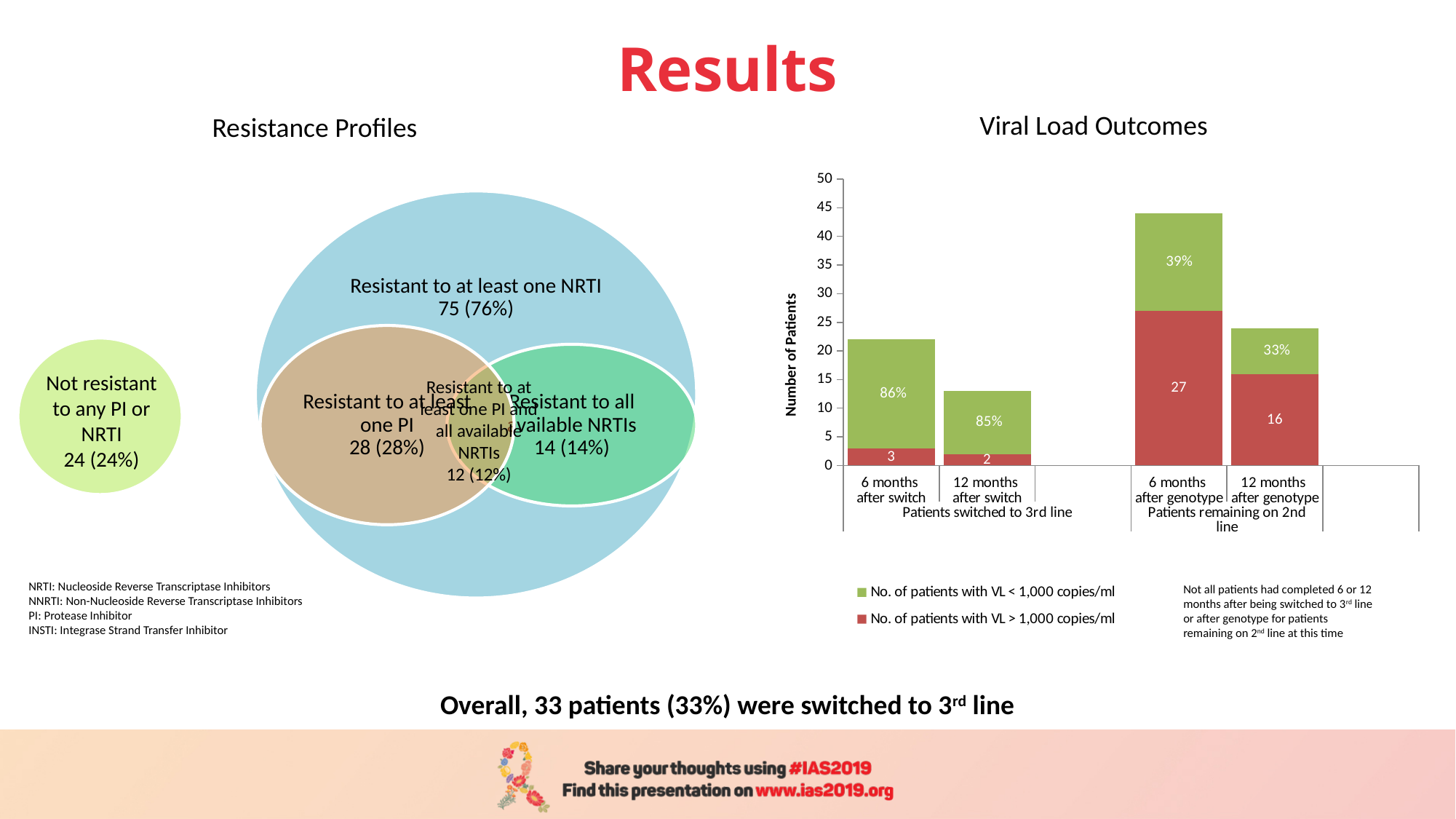
How many series does the legend of the Viral Load Outcomes chart list? 2 In the Viral Load Outcomes chart, what percentage label is shown on the VL < 1,000 copies/ml segment for 6 months after switch? 86% How many bars are plotted in the Viral Load Outcomes chart? 4 In the Viral Load Outcomes chart, is the total height of the bar for 6 months after genotype greater or less than 40? greater In the Viral Load Outcomes chart, what is the number of patients with VL > 1,000 copies/ml at 12 months after switch? 2 In the Viral Load Outcomes chart, what is the number of patients with VL > 1,000 copies/ml at 6 months after genotype? 27 In the Viral Load Outcomes chart, which category has the lowest number of patients with VL > 1,000 copies/ml? 12 months after switch In the Viral Load Outcomes chart, what is the difference between the number of patients with VL > 1,000 copies/ml at 6 months after genotype and at 12 months after genotype? 11 What kind of chart is the Viral Load Outcomes chart? Stacked bar chart In the Viral Load Outcomes chart, is the total height of the bar for 12 months after switch greater or less than 15? less In the Viral Load Outcomes chart, which category has the highest number of patients with VL > 1,000 copies/ml? 6 months after genotype In the Resistance Profiles diagram, how many patients were not resistant to any PI or NRTI? 24 (24%)